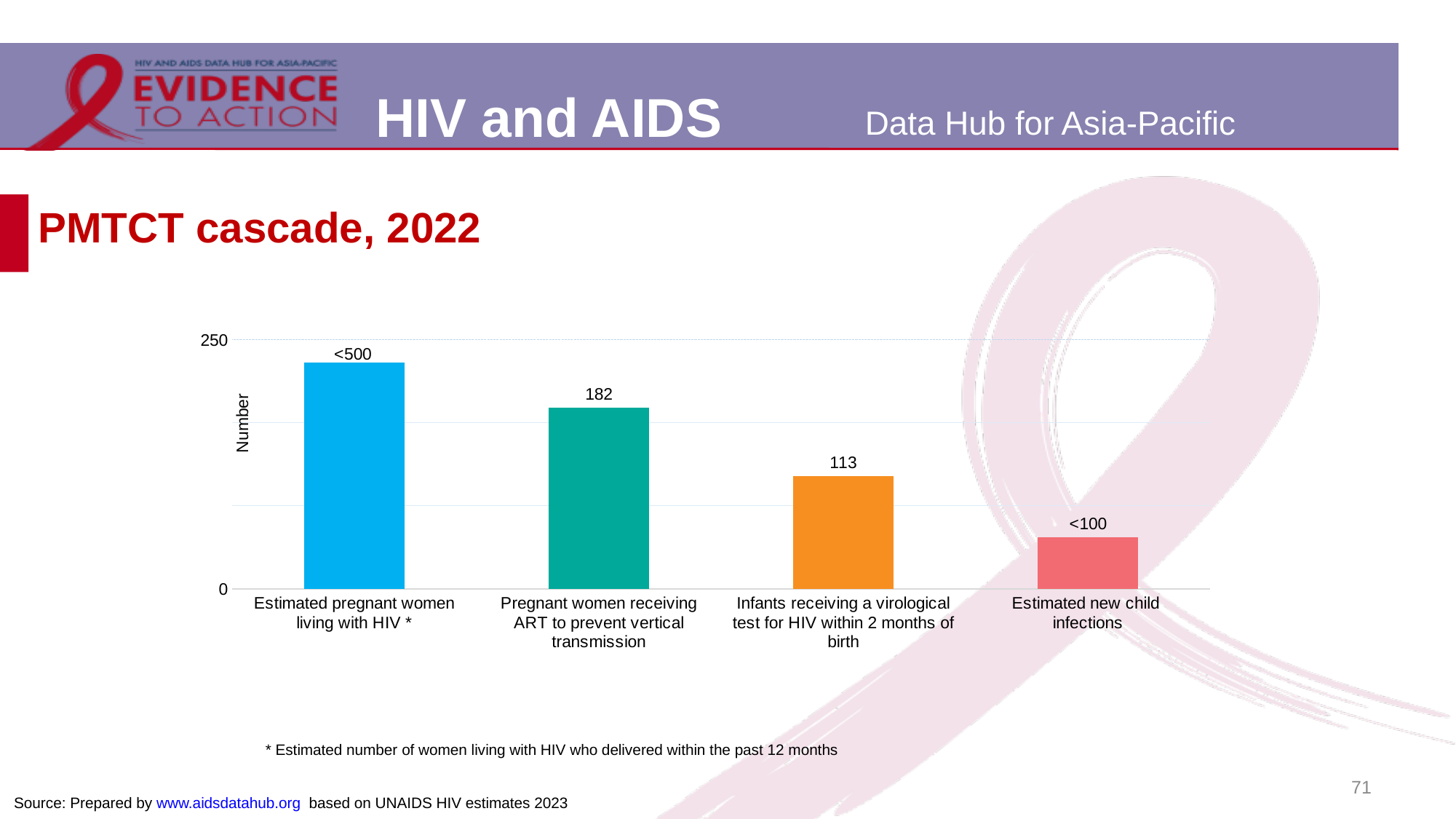
What value is shown for Infants receiving a virological test for HIV within 2 months of birth? 113 Which is larger: the value for Pregnant women receiving ART to prevent vertical transmission or the value for Infants receiving a virological test for HIV within 2 months of birth? Pregnant women receiving ART to prevent vertical transmission What is the difference between the value for Pregnant women receiving ART to prevent vertical transmission and the value for Infants receiving a virological test for HIV within 2 months of birth? 69 What is the label on the vertical axis of the chart? Number Do the bar values rise or fall from left to right across the chart? Fall Which category has the tallest bar? Estimated pregnant women living with HIV Which category has the shortest bar? Estimated new child infections How many categories are shown in the chart? 4 What kind of chart is shown on the slide? Bar chart What value is shown for Pregnant women receiving ART to prevent vertical transmission? 182 What data label is shown for Estimated new child infections? <100 What data label is shown for Estimated pregnant women living with HIV? <500